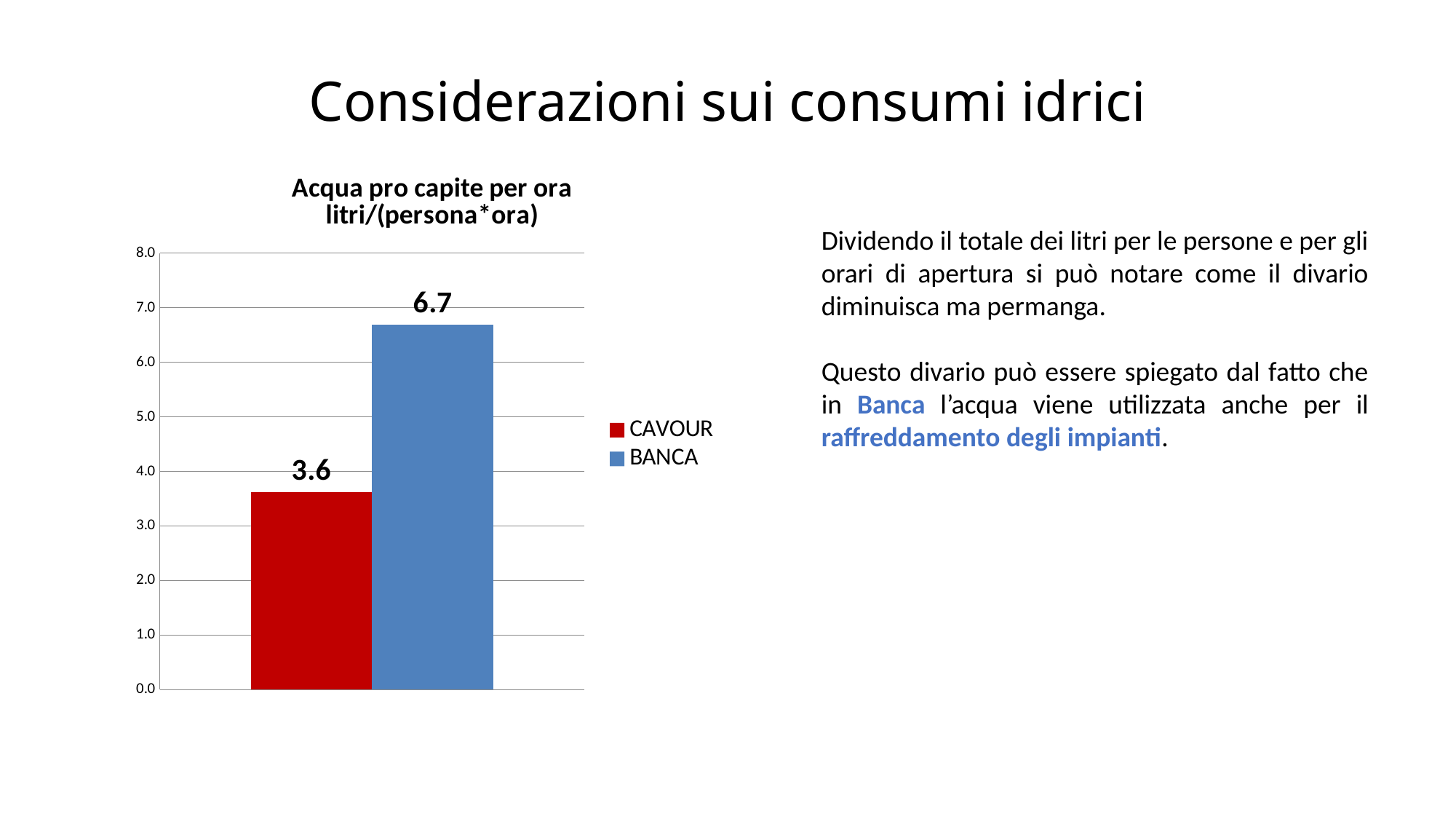
Is the value for CAVOUR greater or less than 4.0? less Which series has the lowest value in the chart? CAVOUR Which series has the highest value in the chart? BANCA How many series does the legend list? 2 What kind of chart is shown on the slide? Bar chart What colour is the BANCA bar in the chart? Blue What is the difference between the BANCA value and the CAVOUR value? 3.1 Is the value for BANCA greater or less than 6.0? greater What is the title of the chart? Acqua pro capite per ora litri/(persona*ora) What is the value for BANCA in the chart? 6.7 Which is larger, the value for CAVOUR or the value for BANCA? BANCA What is the value for CAVOUR in the chart? 3.6